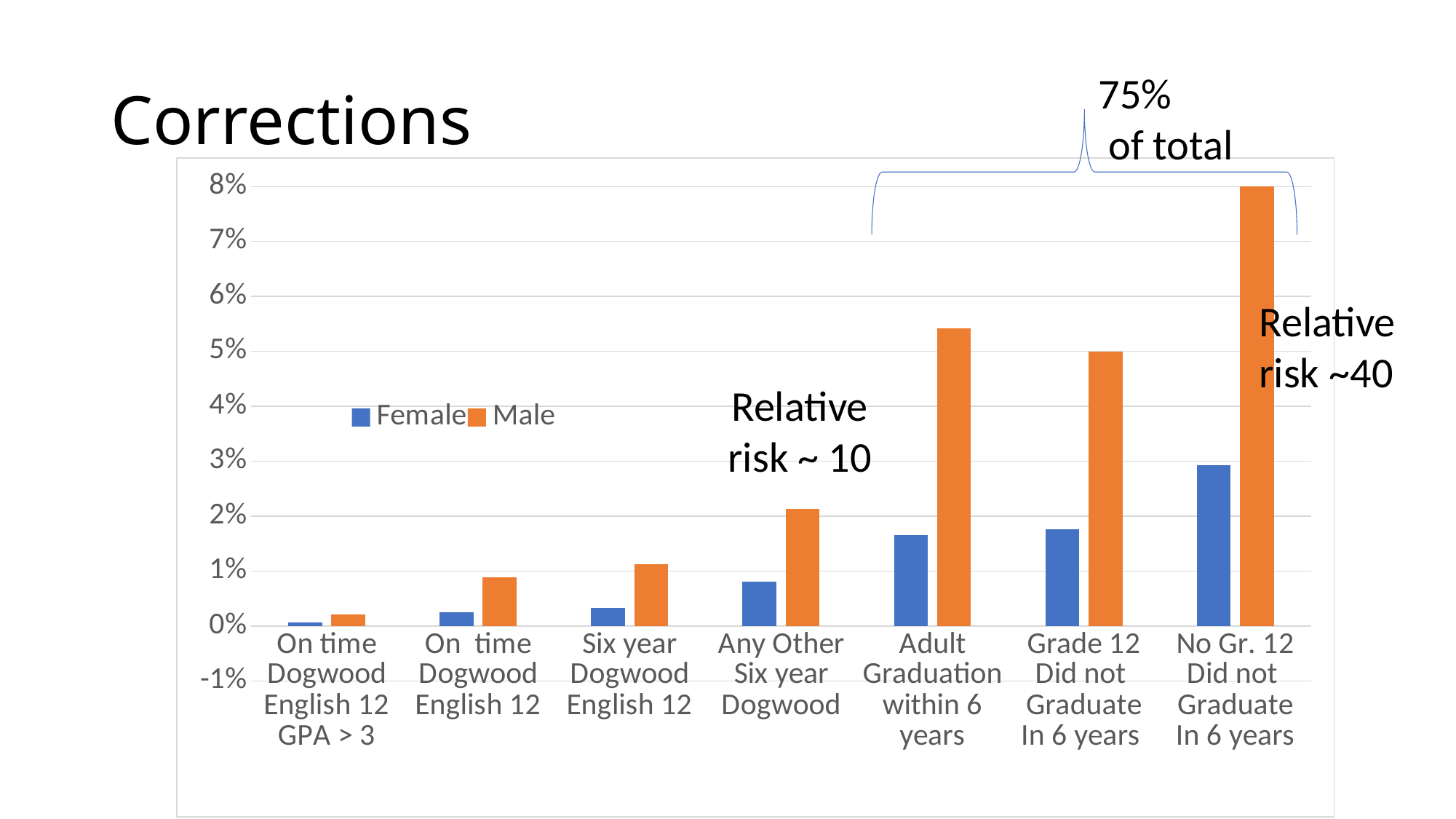
How many series does the legend list? 2 What kind of chart is shown on the slide? bar chart How many categories are shown on the x axis? 7 Is the Male value for Adult Graduation within 6 years greater or less than 5%? greater Do the Male values generally rise or fall moving from left to right along the x axis? rise Which category has the highest Male value? No Gr. 12 Did not Graduate In 6 years What colour are the Male bars? orange Which is larger for Grade 12 Did not Graduate In 6 years, the Female value or the Male value? Male Which category has the lowest Female value? On time Dogwood English 12 GPA > 3 Is the Male value for No Gr. 12 Did not Graduate In 6 years greater or less than 7%? greater